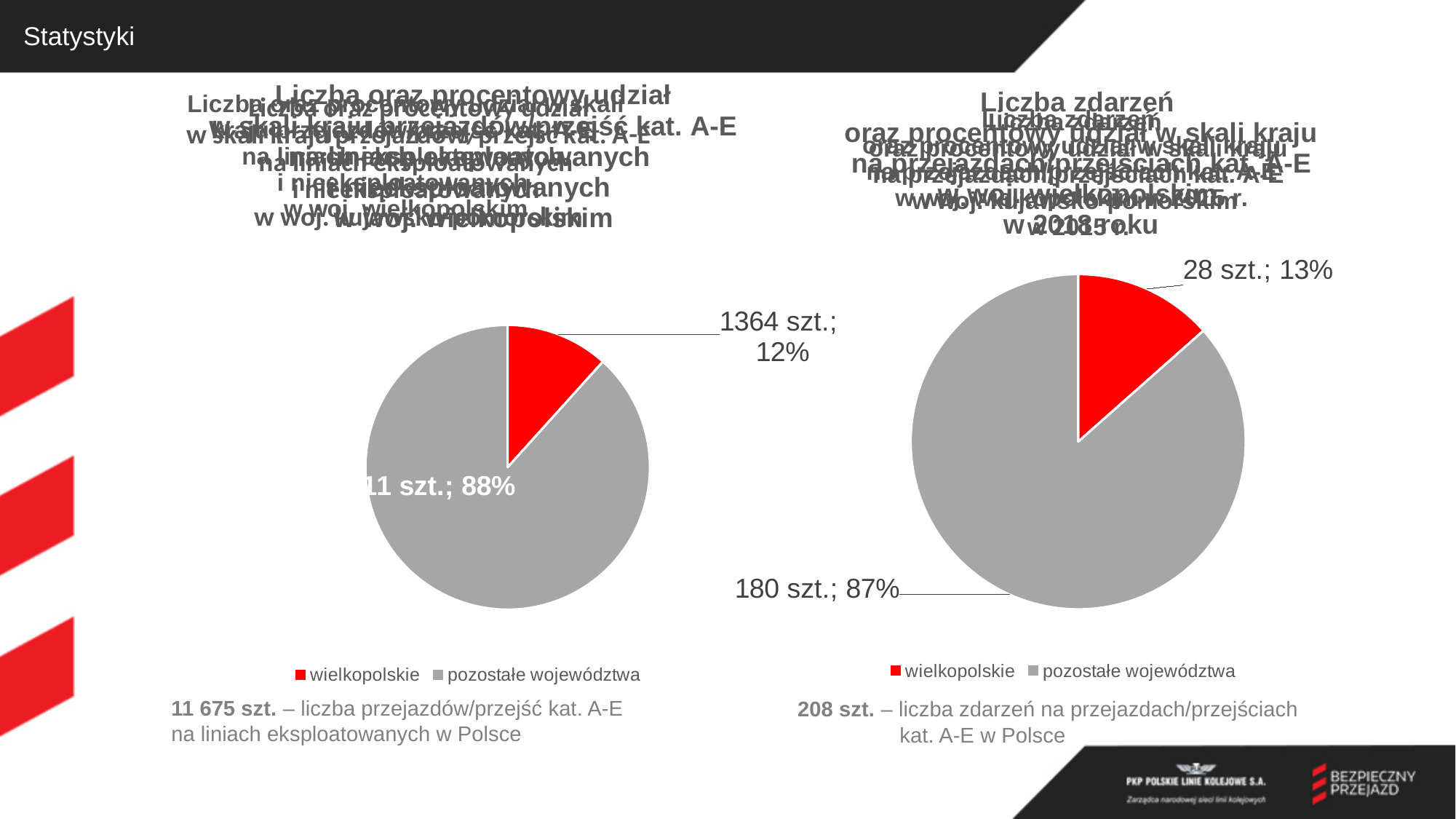
In the left pie chart, what share of the pie does pozostałe województwa have? 88% In the right pie chart, what is the difference between the values for pozostałe województwa and wielkopolskie? 152 szt. What kind of chart is the chart on the right? pie chart How many slices does the right pie chart have? 2 In the left chart, what colour is the wielkopolskie slice? red In the left pie chart, what share of the pie does wielkopolskie have? 12% In the right pie chart, what share of the pie does wielkopolskie have? 13% In the left pie chart, which slice is larger, wielkopolskie or pozostałe województwa? pozostałe województwa In the right pie chart, what value is shown for pozostałe województwa? 180 szt. In the left pie chart, what value is shown for wielkopolskie? 1364 szt. In the right pie chart, what is the total of the two slices? 208 szt. In the right pie chart, what value is shown for wielkopolskie? 28 szt.